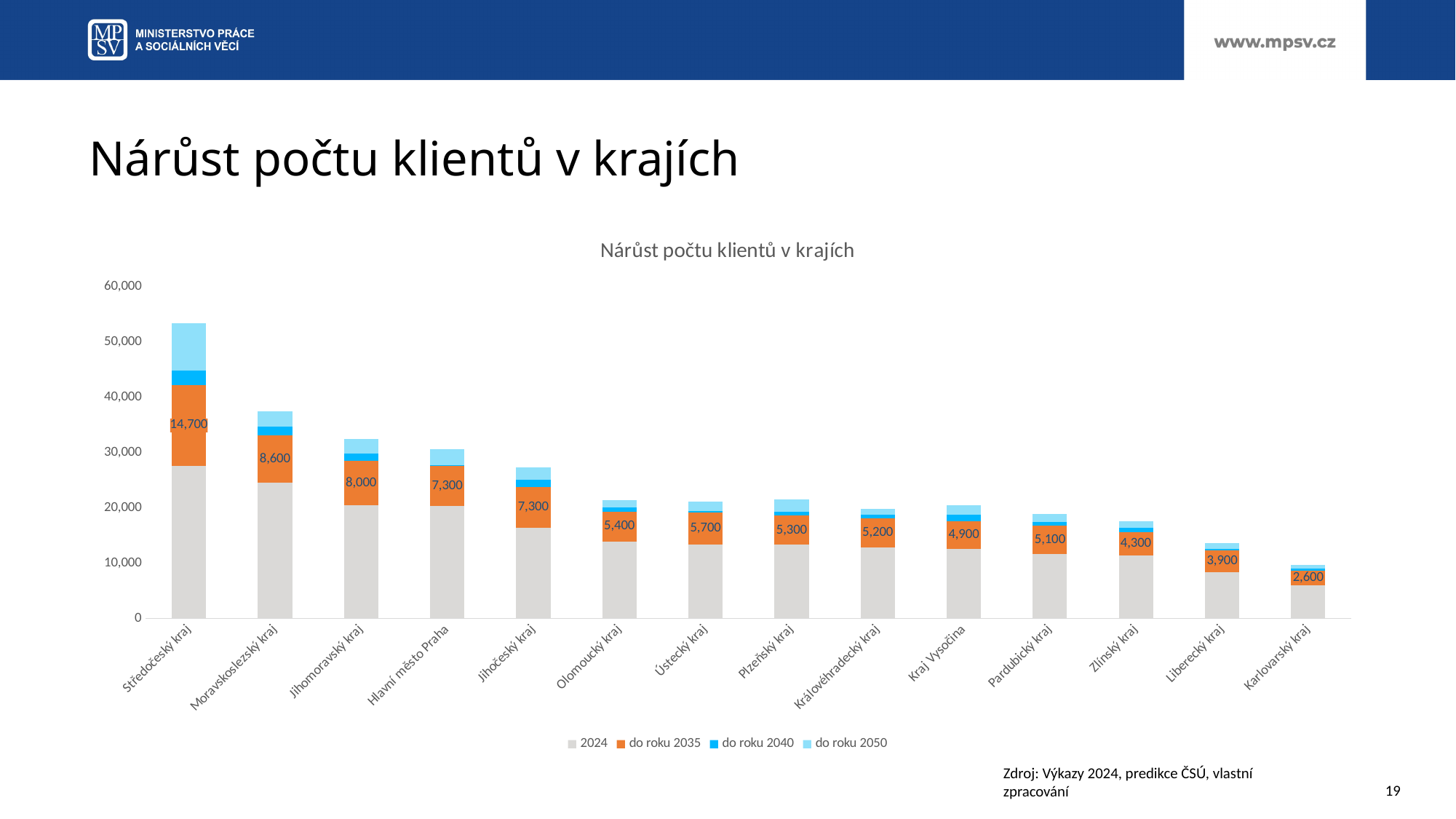
How many regions (categories) are shown on the x axis? 14 Which has the larger 'do roku 2035' value, Ústecký kraj or Plzeňský kraj? Ústecký kraj What is the 'do roku 2035' value for Karlovarský kraj? 2,600 Which region has the lowest 'do roku 2035' value? Karlovarský kraj What is the difference between the 'do roku 2035' values for Středočeský kraj and Moravskoslezský kraj? 6,100 Is the total stacked value for Středočeský kraj greater or less than 50,000? greater Which region has the highest 'do roku 2035' value? Středočeský kraj What is the title of the chart? Nárůst počtu klientů v krajích How many series does the legend list? 4 What is the 'do roku 2035' value for Hlavní město Praha? 7,300 What is the 'do roku 2035' value for Středočeský kraj? 14,700 What kind of chart is shown on the slide? stacked bar chart